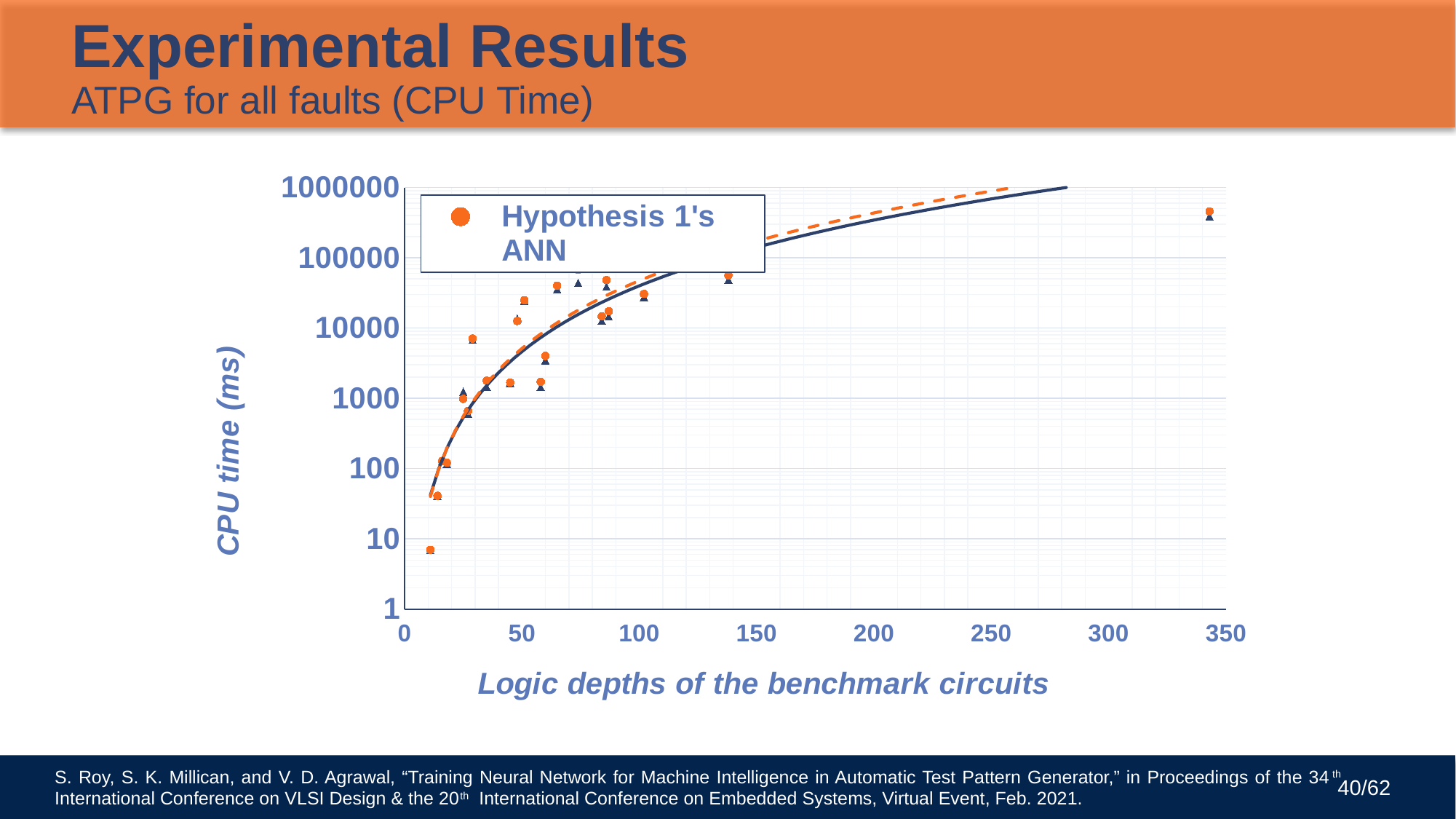
What is the title of the x axis of the chart? Logic depths of the benchmark circuits Is the CPU time for the point at a logic depth of about 340 greater or less than 100000? greater Does CPU time generally rise or fall as logic depth increases along the x axis? Rise What is the title of the y axis of the chart? CPU time (ms) Is the CPU time for the point at a logic depth of about 140 greater or less than 10000? greater Is the CPU time for the lowest point near a logic depth of 10 greater or less than 10? less What kind of chart is shown on the slide? Scatter chart Which has the higher CPU time: the point at a logic depth of about 340 or the point at a logic depth of about 140? The point at about 340